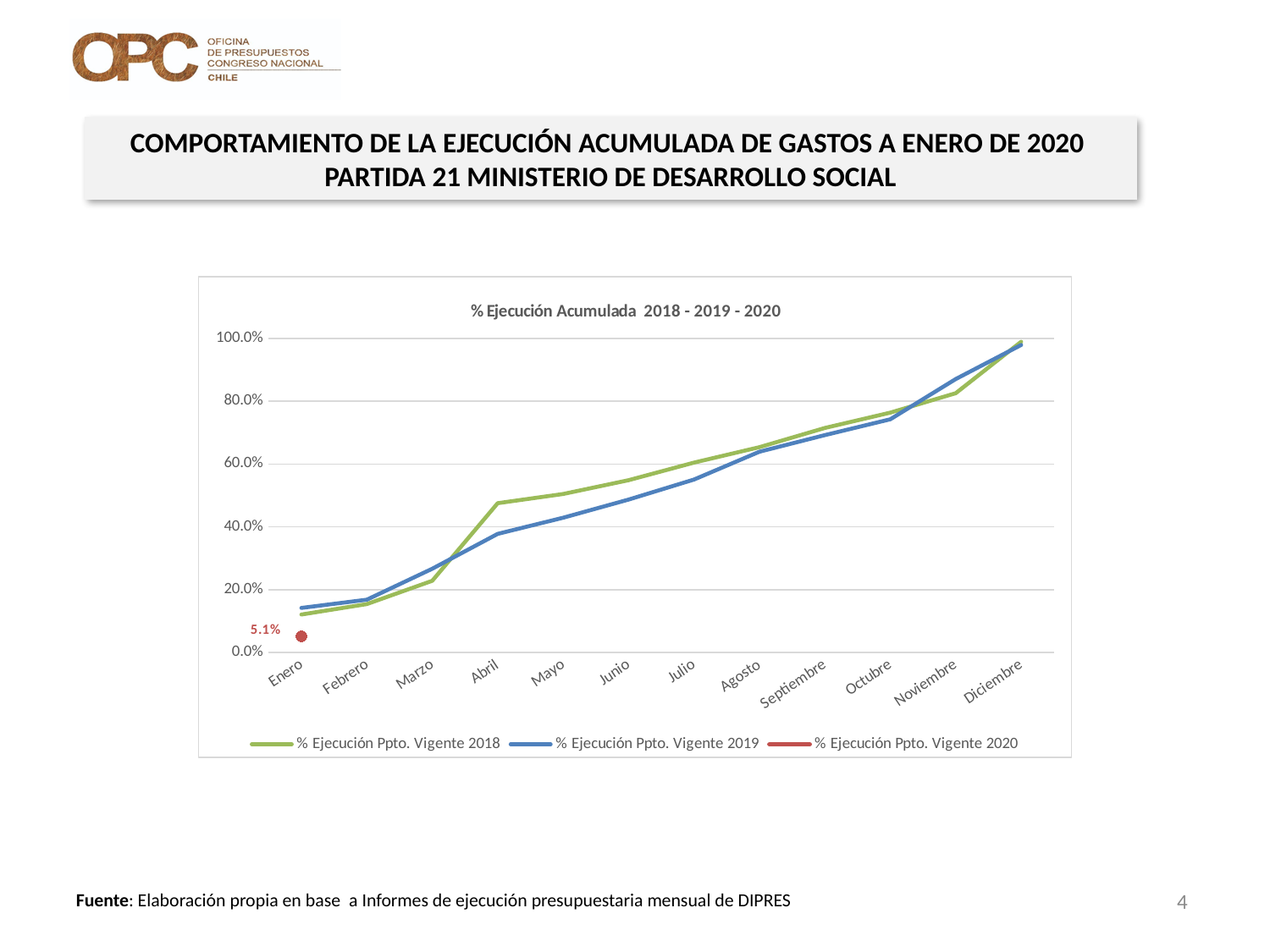
Is the value for % Ejecución Ppto. Vigente 2019 in Julio greater or less than 60%? less Is the value for % Ejecución Ppto. Vigente 2019 in Abril greater or less than 40%? less How many series does the legend list? 3 What is the value for % Ejecución Ppto. Vigente 2020 in Enero? 5.1% What is the title of the chart? % Ejecución Acumulada 2018 - 2019 - 2020 Is the value for % Ejecución Ppto. Vigente 2018 in Enero greater or less than 20%? less Do the values for % Ejecución Ppto. Vigente 2019 rise or fall from Enero to Diciembre? Rise How many months are shown on the x axis? 12 In Enero, which series has the larger value: % Ejecución Ppto. Vigente 2019 or % Ejecución Ppto. Vigente 2020? % Ejecución Ppto. Vigente 2019 What kind of chart is shown on the slide? Line chart In Abril, which series has the larger value: % Ejecución Ppto. Vigente 2018 or % Ejecución Ppto. Vigente 2019? % Ejecución Ppto. Vigente 2018